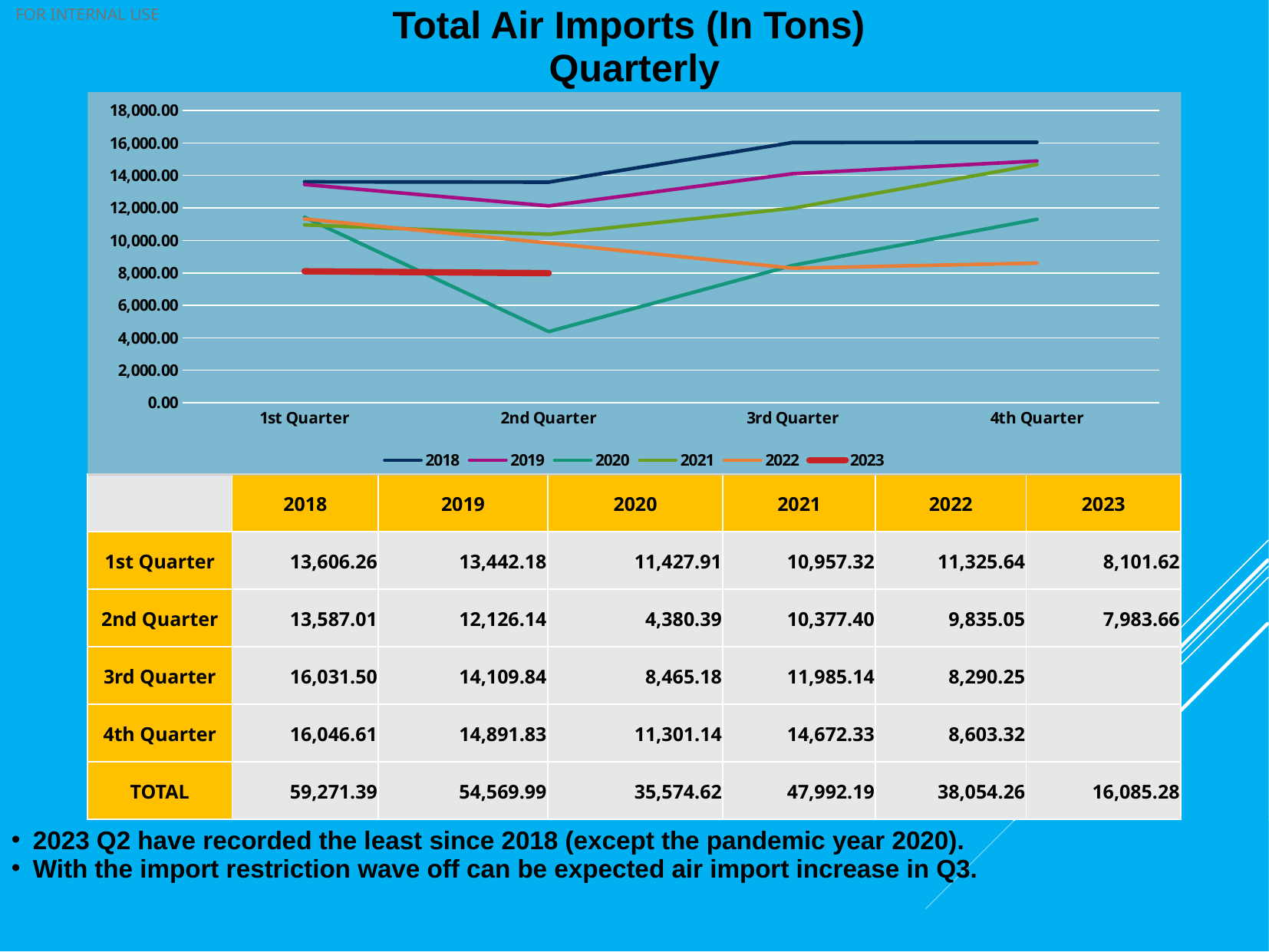
Is the value for 2020 in the 2nd Quarter greater or less than 6,000.00? less What is the TOTAL shown for 2023? 16,085.28 In which quarter does the 2019 series reach its highest value? 4th Quarter Does the 2022 series rise or fall from the 1st Quarter to the 4th Quarter? fall How many quarters are plotted along the x axis of the chart? 4 What is the value for 2018 in the 3rd Quarter? 16,031.50 Which year has the lowest value in the 2nd Quarter? 2020 What kind of chart is shown on the slide? line chart How many series does the chart legend list? 6 What is the value for 2020 in the 2nd Quarter? 4,380.39 Which is larger in the 3rd Quarter, the value for 2021 or the value for 2022? 2021 What is the difference between the 1st Quarter values for 2018 and 2023? 5,504.64